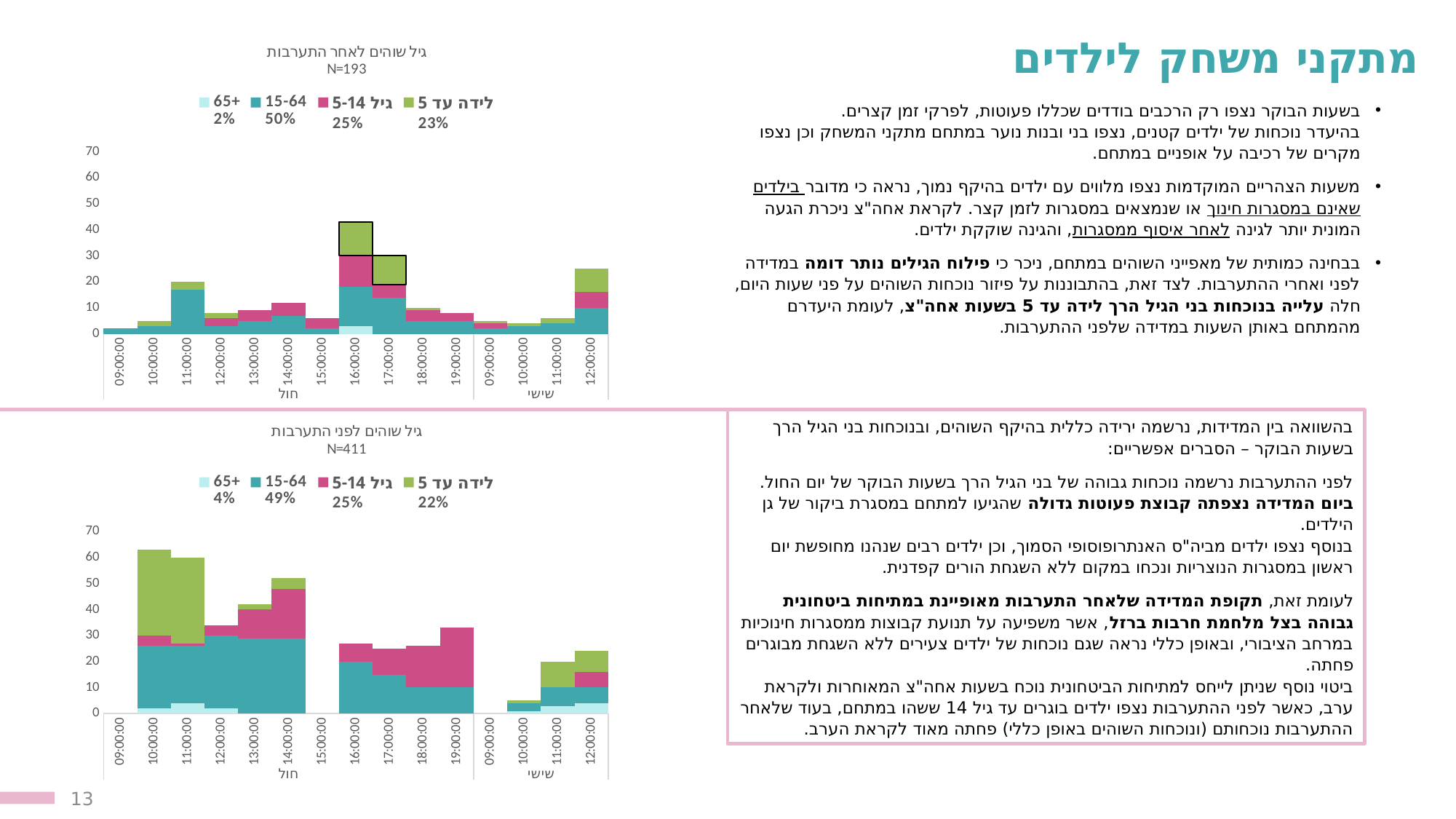
What kind of chart is the top chart titled 'גיל שוהים לאחר התערבות'? stacked bar chart In the top chart 'גיל שוהים לאחר התערבות', which time slot has the tallest bar? 16:00:00 (חול) In the top chart 'גיל שוהים לאחר התערבות', is the total for 16:00:00 on חול greater or less than 30? greater In the bottom chart 'גיל שוהים לפני התערבות', is the total for 10:00:00 on חול greater or less than 50? greater In the bottom chart 'גיל שוהים לפני התערבות', which time slot has the tallest bar? 10:00:00 (חול) What is the N value shown in the title of the bottom chart 'גיל שוהים לפני התערבות'? N=411 How many series does the legend of the bottom chart 'גיל שוהים לפני התערבות' list? 4 In the bottom chart 'גיל שוהים לפני התערבות', which bar is taller: 16:00:00 on חול or 12:00:00 on שישי? 16:00:00 on חול According to the legend of the top chart 'גיל שוהים לאחר התערבות', what share is the 15-64 age group? 50% How many time-slot categories are shown on the x axis of the bottom chart 'גיל שוהים לפני התערבות'? 15 In the top chart 'גיל שוהים לאחר התערבות', which bar is taller: 11:00:00 on חול or 12:00:00 on שישי? 12:00:00 on שישי In the top chart 'גיל שוהים לאחר התערבות', is the total for 15:00:00 on חול greater or less than 10? less